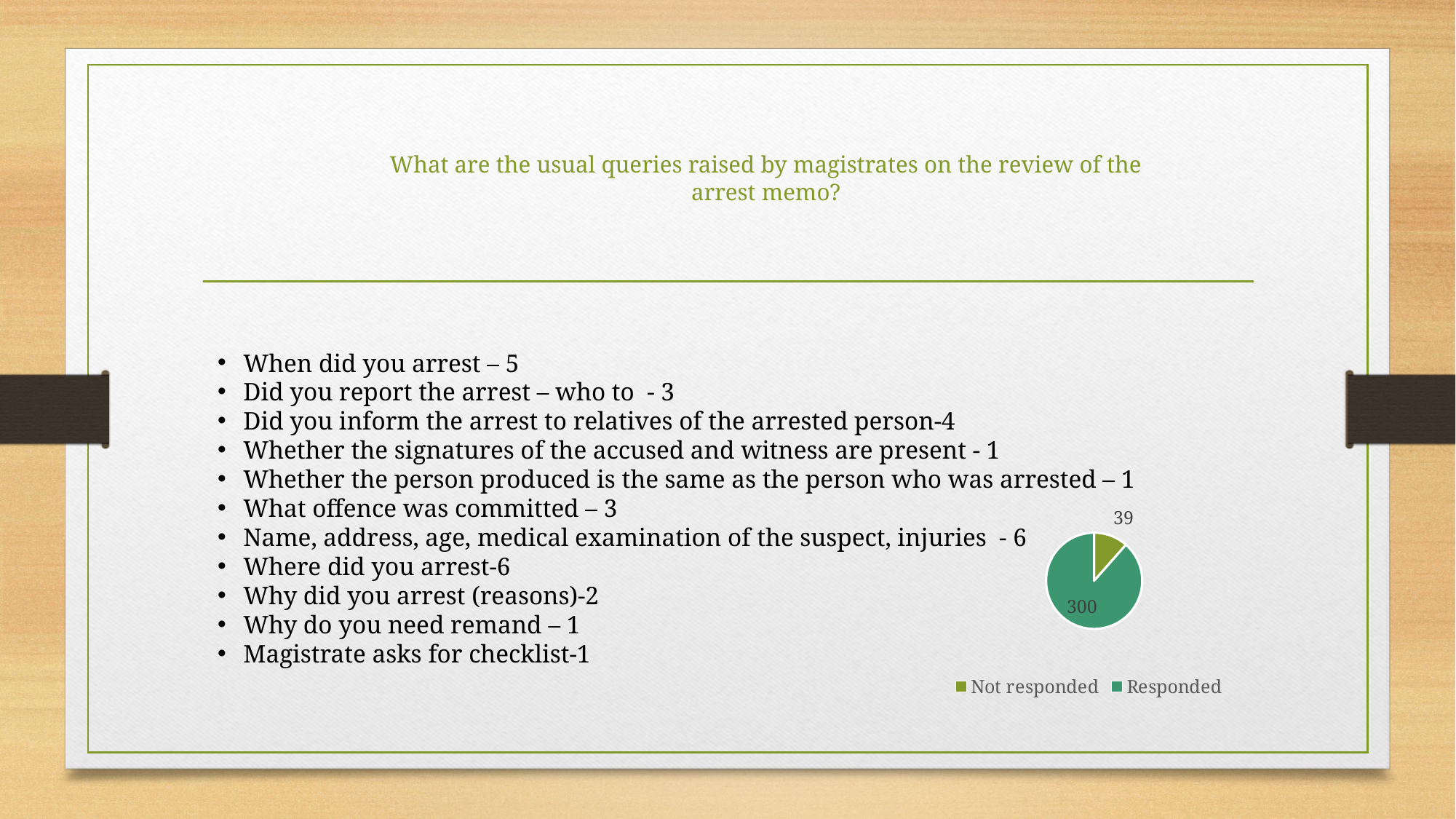
In the pie chart, what is the value for Responded? 300 How many slices does the pie chart have? 2 What type of chart is shown on the slide? pie chart What are the two legend entries of the pie chart? Not responded and Responded In the pie chart, what is the value for Not responded? 39 Which legend entry in the pie chart is shown in the darker teal-green colour? Responded What is the difference between the Responded and Not responded values in the pie chart? 261 Which is larger in the pie chart, Responded or Not responded? Responded Which slice of the pie chart is the largest? Responded What is the total of the two values shown in the pie chart? 339 How many entries does the pie chart legend list? 2 Which slice of the pie chart is the smallest? Not responded